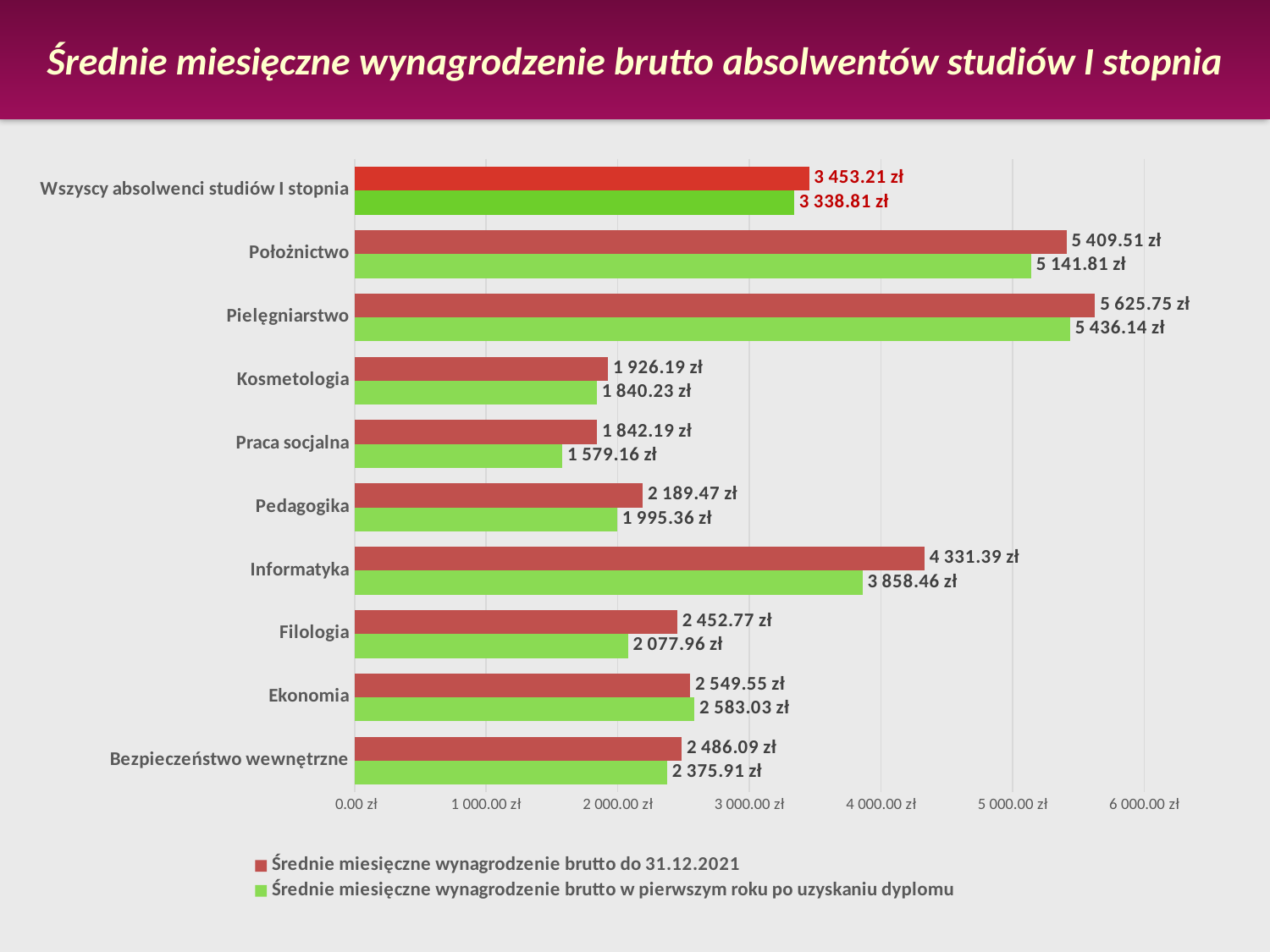
What is the value of 'Średnie miesięczne wynagrodzenie brutto do 31.12.2021' for Wszyscy absolwenci studiów I stopnia? 3 453.21 zł Which category has the highest value for 'Średnie miesięczne wynagrodzenie brutto do 31.12.2021'? Pielęgniarstwo What is the difference between the two series values for Informatyka? 472.93 zł What is the value of 'Średnie miesięczne wynagrodzenie brutto w pierwszym roku po uzyskaniu dyplomu' for Filologia? 2 077.96 zł What is the title of the chart on the slide? Średnie miesięczne wynagrodzenie brutto absolwentów studiów I stopnia Which category has the lowest value for 'Średnie miesięczne wynagrodzenie brutto w pierwszym roku po uzyskaniu dyplomu'? Praca socjalna What is the value of 'Średnie miesięczne wynagrodzenie brutto do 31.12.2021' for Informatyka? 4 331.39 zł How many series does the legend list? 2 How many categories are shown on the vertical axis of the chart? 10 What type of chart is shown on the slide? Bar chart Is the value of 'Średnie miesięczne wynagrodzenie brutto do 31.12.2021' for Położnictwo greater or less than 5 000.00 zł? greater For Ekonomia, which series has the larger value: 'do 31.12.2021' or 'w pierwszym roku po uzyskaniu dyplomu'? w pierwszym roku po uzyskaniu dyplomu